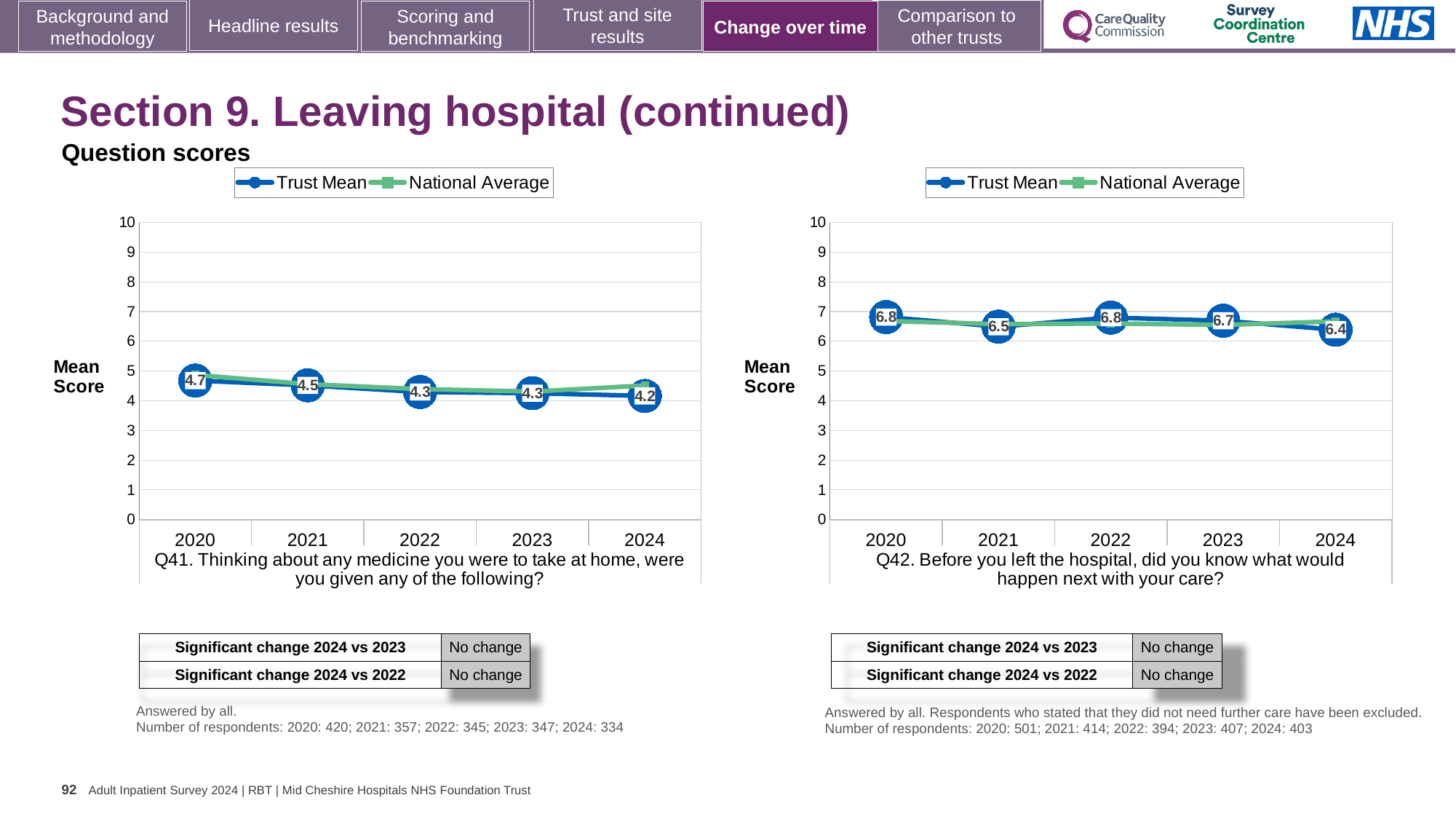
On the Q42 chart, which year has the lowest Trust Mean score? 2024 On the Q42 chart, what is the Trust Mean score for 2021? 6.5 On the Q42 chart, is the Trust Mean score for 2020 or 2021 larger? 2020 On the Q42 chart, what is the Trust Mean score for 2024? 6.4 How many years are plotted on the Q41 chart? 5 How many series does the legend of the Q42 chart list? 2 On the Q41 chart, what is the Trust Mean score for 2024? 4.2 On the Q41 chart, which year has the highest Trust Mean score? 2020 On the Q41 chart, what is the difference between the Trust Mean scores for 2020 and 2024? 0.5 On the Q41 chart, is the Trust Mean score for 2022 greater or less than 5? less On the Q42 chart, what is the difference between the Trust Mean scores for 2022 and 2024? 0.4 On the Q41 chart, what is the Trust Mean score for 2020? 4.7